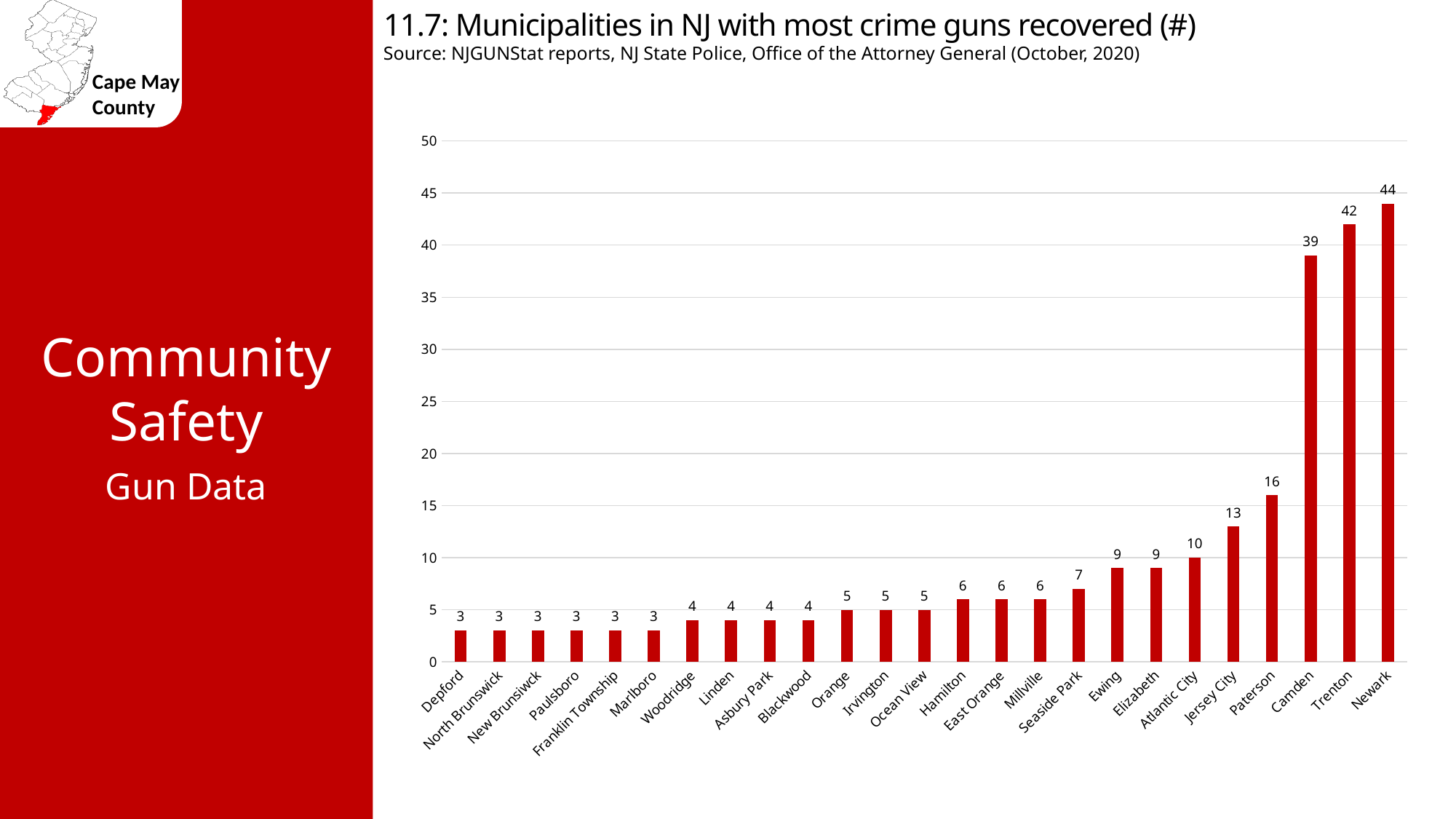
What is the difference between the values for Paterson and Atlantic City? 6 Which municipality has the highest number of crime guns recovered? Newark How many municipalities are shown on the chart? 25 Is the value for Trenton greater or less than 40? greater What is the difference between the values for Newark and Trenton? 2 What is the value shown for Jersey City? 13 What is the source cited for the chart? NJGUNStat reports, NJ State Police, Office of the Attorney General (October, 2020) How many crime guns were recovered in Camden? 39 What kind of chart is shown on the slide? Bar chart How many crime guns were recovered in Seaside Park? 7 Which has a higher value, Ewing or Hamilton? Ewing Which has a higher value, Camden or Paterson? Camden